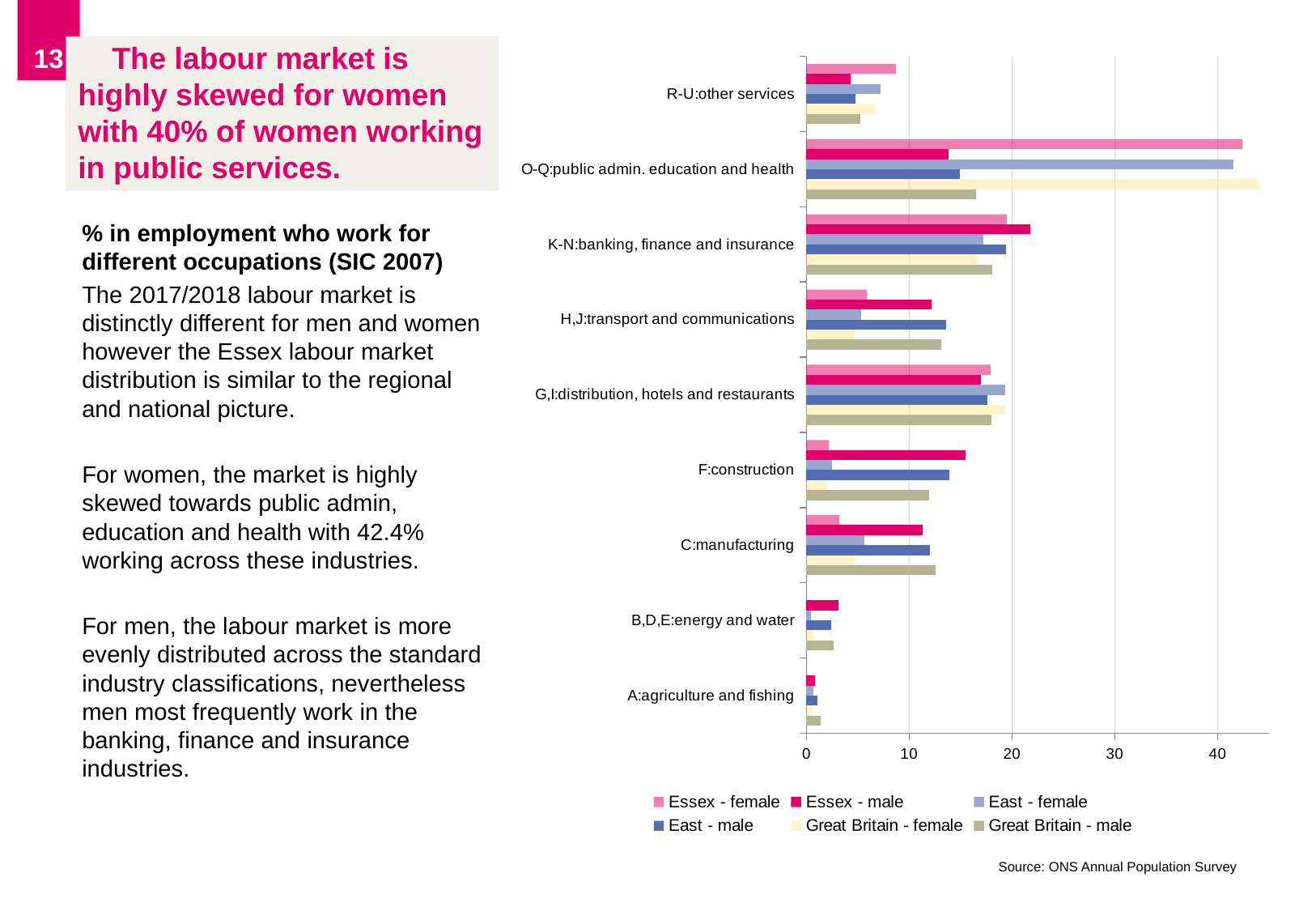
For H,J:transport and communications, which is larger: the Essex - male value or the Essex - female value? Essex - male How many series does the chart's legend list? 6 Is the Essex - female value for O-Q:public admin. education and health greater or less than 40? greater Is the Essex - male value for F:construction greater or less than 10? greater What kind of chart is shown on the slide? bar chart Is the Essex - female value for C:manufacturing greater or less than 10? less For O-Q:public admin. education and health, which is larger: the Essex - female value or the Essex - male value? Essex - female For the Essex - female series, which industry category has the highest value? O-Q:public admin. education and health What source is cited for the chart's data? ONS Annual Population Survey For the Essex - male series, which industry category has the lowest value? A:agriculture and fishing For the Essex - male series, which industry category has the highest value? K-N:banking, finance and insurance How many industry categories are shown on the chart? 9